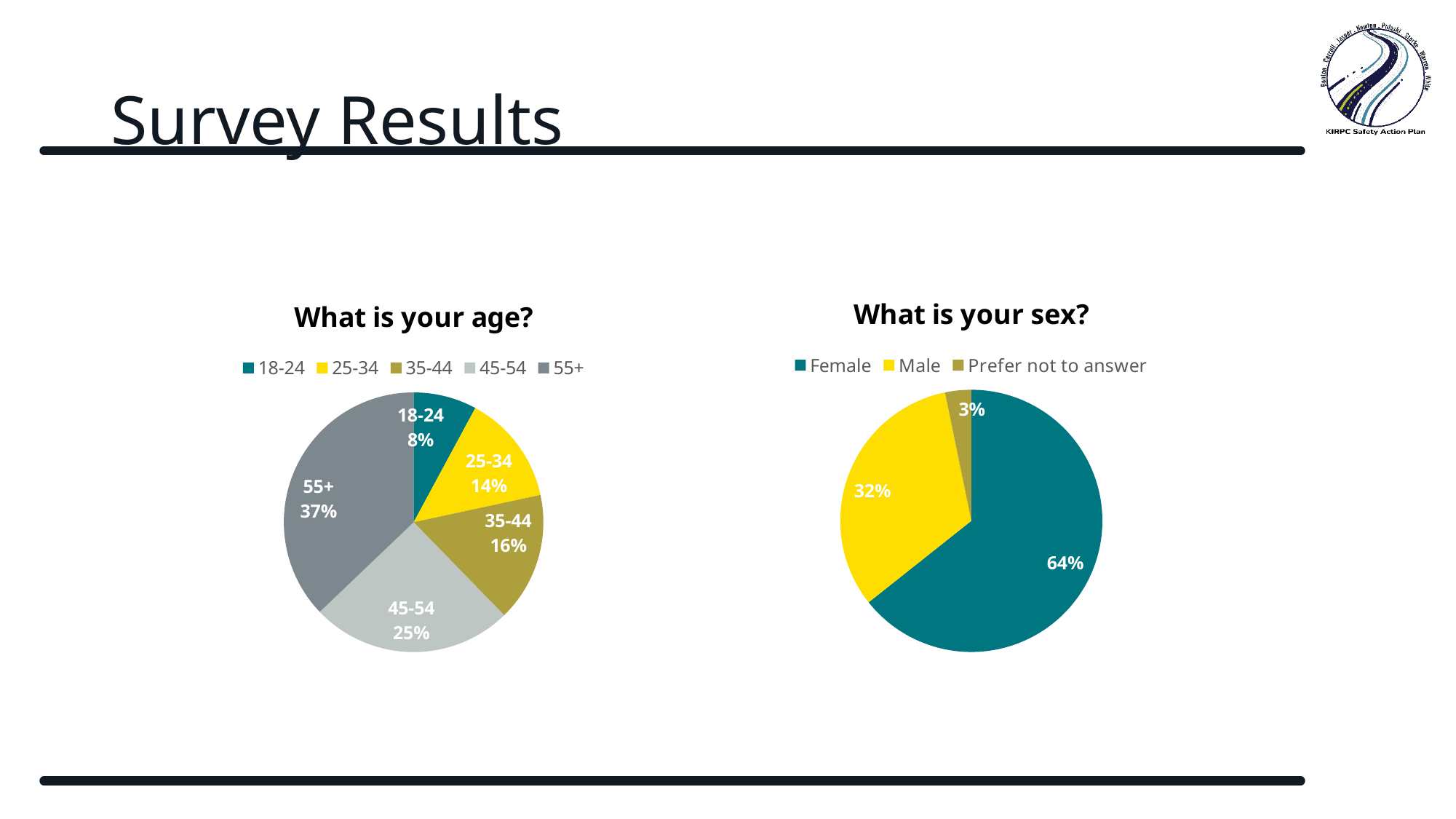
In the "What is your age?" chart, which age group has the smallest share? 18-24 What type of chart is used for "What is your sex?"? Pie chart In the "What is your age?" chart, which age group has the largest share? 55+ How many entries does the legend of the "What is your sex?" chart list? 3 In the "What is your sex?" chart, what percentage chose "Prefer not to answer"? 3% In the "What is your age?" chart, what is the difference in percentage points between the 55+ and 35-44 groups? 21 In the "What is your age?" chart, what share of respondents are aged 45-54? 25% In the "What is your sex?" chart, what is the difference in percentage points between Female and Male? 32 In the "What is your sex?" chart, what percentage of respondents are Male? 32% In the "What is your age?" chart, what percentage is shown for the 18-24 group? 8% In the "What is your age?" chart, which is larger, the 25-34 share or the 35-44 share? 35-44 How many age groups are shown in the "What is your age?" chart? 5